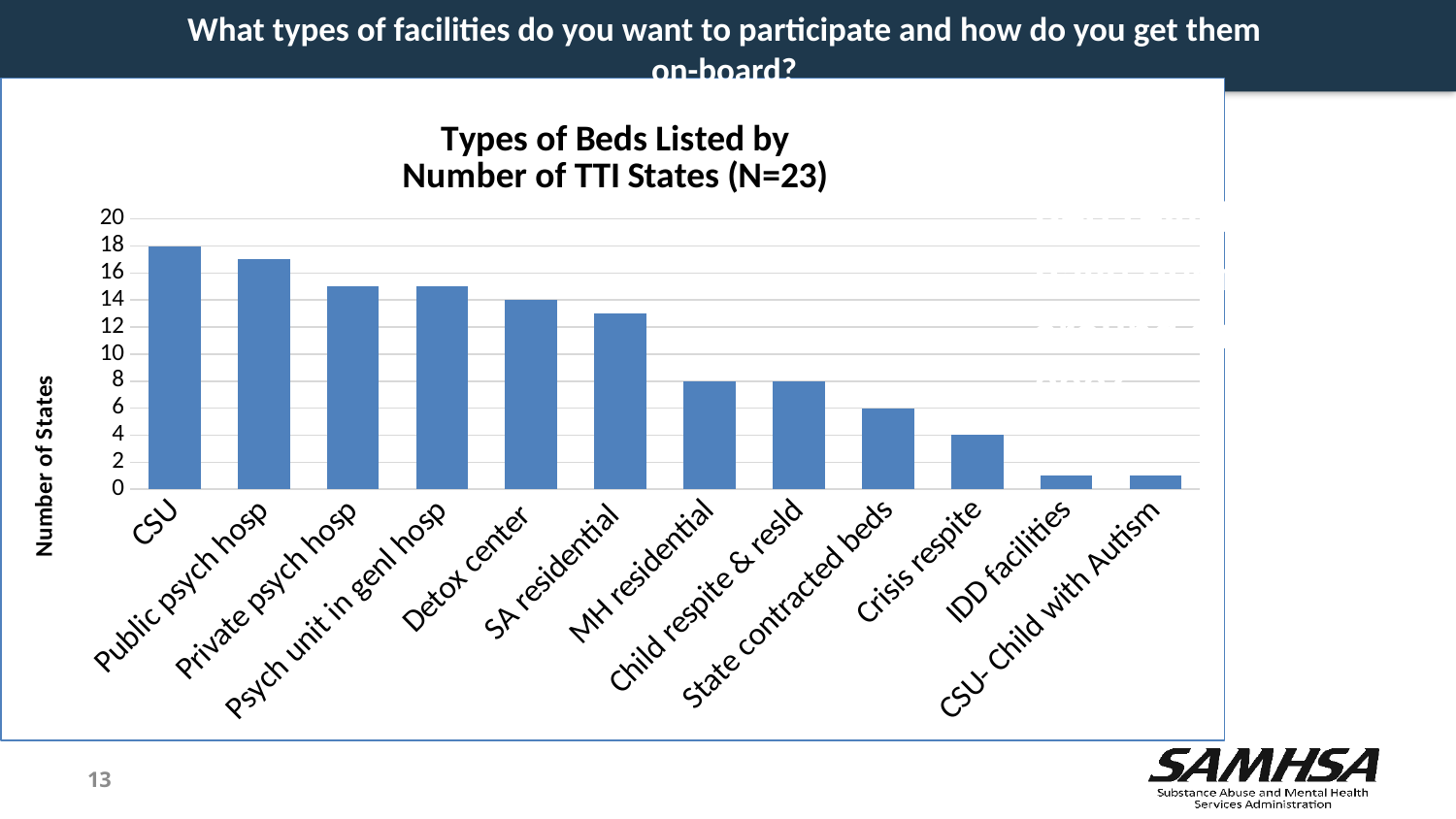
How many bed-type categories are plotted on the chart? 12 Do the values generally rise or fall moving from left to right along the x axis? fall How many states listed CSU beds? 18 Is the value for IDD facilities greater or less than 2? less What is the title of the chart? Types of Beds Listed by Number of TTI States (N=23) How many states listed Crisis respite beds? 4 What is the difference between the number of states listing CSU beds and the number listing Detox center beds? 4 How many states listed Detox center beds? 14 Is the value for Public psych hosp greater or less than 16? greater What type of chart is shown on the slide? bar chart Which bed type is listed by the highest number of states? CSU How many states listed State contracted beds? 6